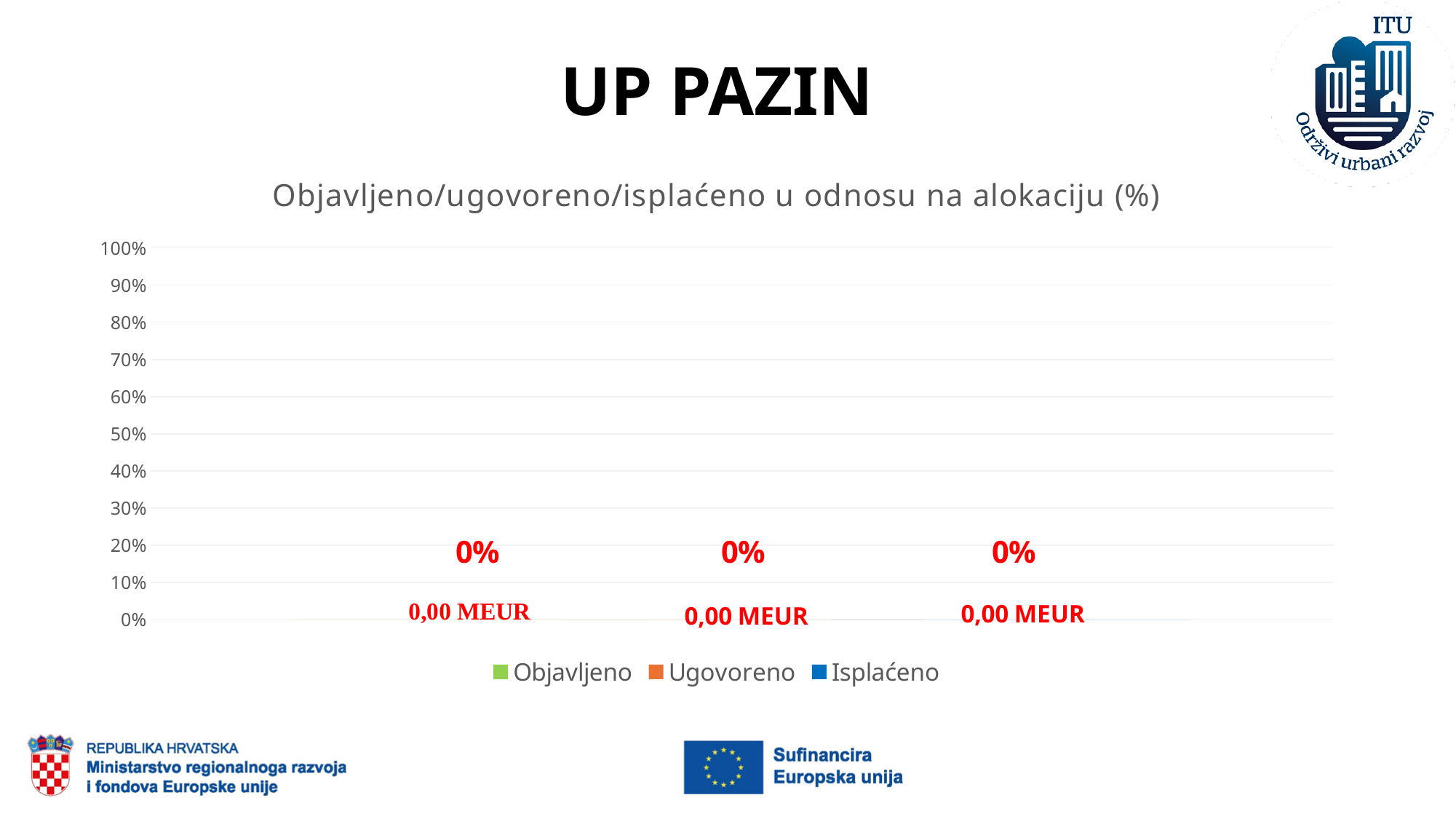
How many data points are labelled on the chart? 3 What is the title of the chart? Objavljeno/ugovoreno/isplaćeno u odnosu na alokaciju (%) Is the value for Ugovoreno greater or less than 50%? less What is the highest value shown on the vertical axis? 100% What is the value for Ugovoreno? 0% What amount in MEUR is shown for Isplaćeno? 0,00 MEUR What kind of chart is shown on the slide? bar chart How many series does the chart legend list? 3 What amount in MEUR is shown for Objavljeno? 0,00 MEUR What is the value for Isplaćeno? 0% What is the value for Objavljeno? 0% What is the difference between the values for Objavljeno and Isplaćeno? 0%